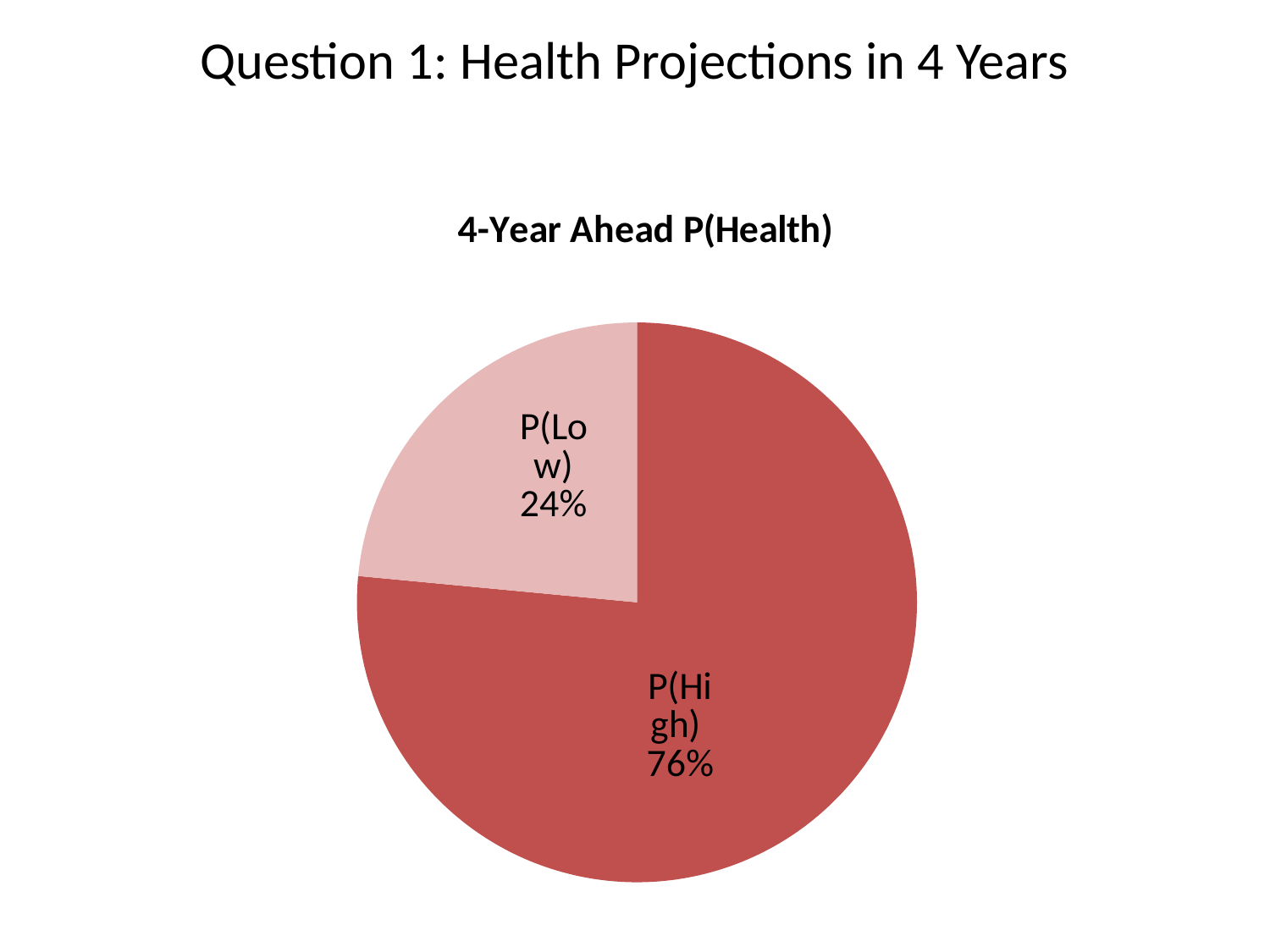
Which slice is drawn in the lighter pink colour? P(Low) What is the title of the chart? 4-Year Ahead P(Health) What percentage is shown for the P(Low) slice? 24% Which slice is the largest in the pie chart? P(High) What share of the pie does the P(Low) slice represent? 24% How many slices does the pie chart have? 2 Which is larger, the P(High) slice or the P(Low) slice? P(High) What percentage is shown for the P(High) slice? 76% What is the difference in percentage points between the P(High) and P(Low) slices? 52 What kind of chart is shown on the slide? pie chart Which slice is the smallest in the pie chart? P(Low)